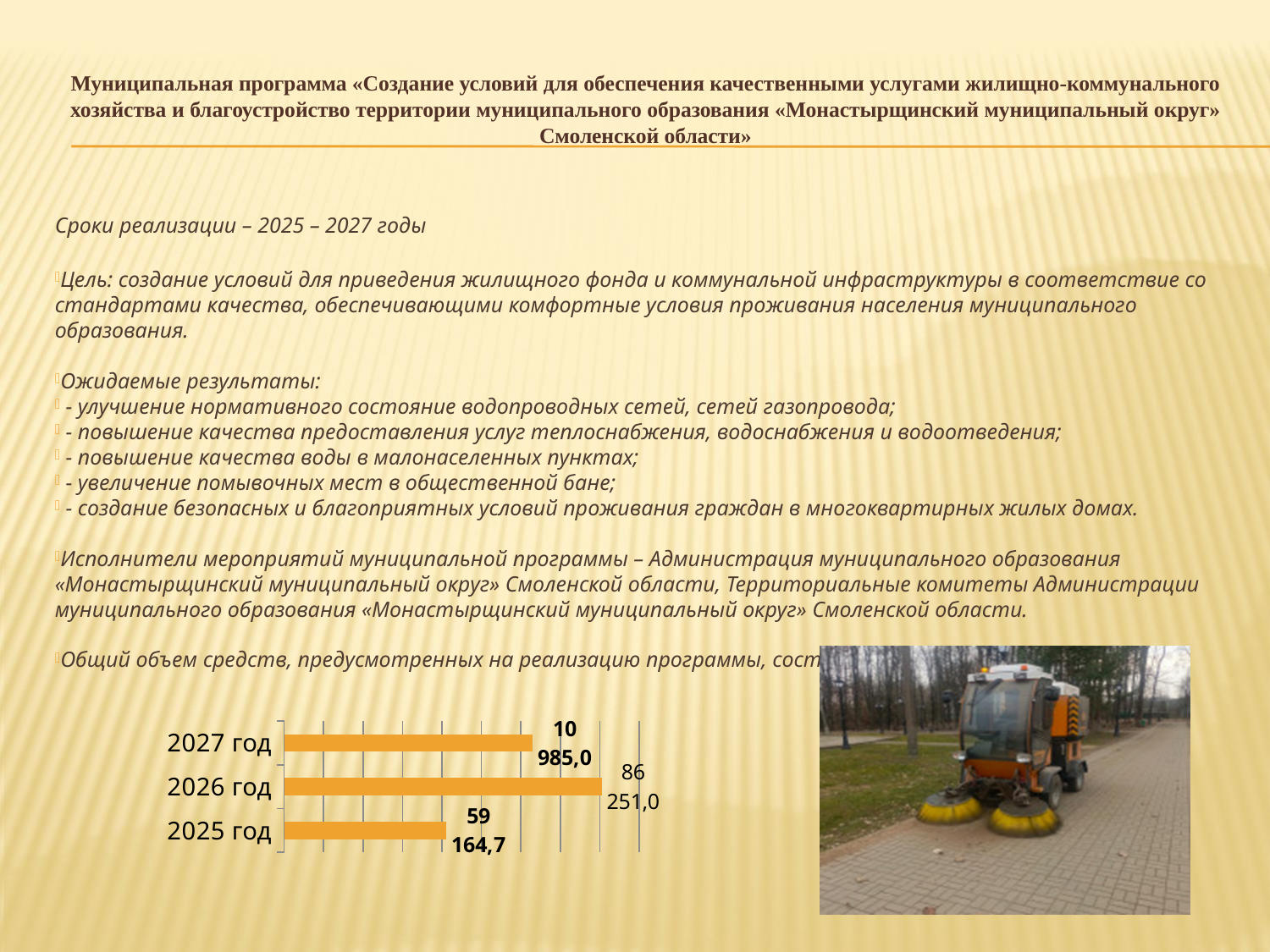
Which years are listed as categories on the vertical axis of the bar chart? 2027 год, 2026 год, 2025 год What is the difference between the values for 2026 год and 2025 год in the bar chart? 27 086,3 What is the value shown for 2026 год in the bar chart? 86 251,0 What is the value shown for 2025 год in the bar chart? 59 164,7 How many categories (years) does the bar chart show? 3 What kind of chart is shown at the bottom of the slide? bar chart What colour are the bars in the chart? orange Which year has the longest bar in the chart? 2026 год Which is larger in the bar chart, the value for 2026 год or for 2025 год? 2026 год